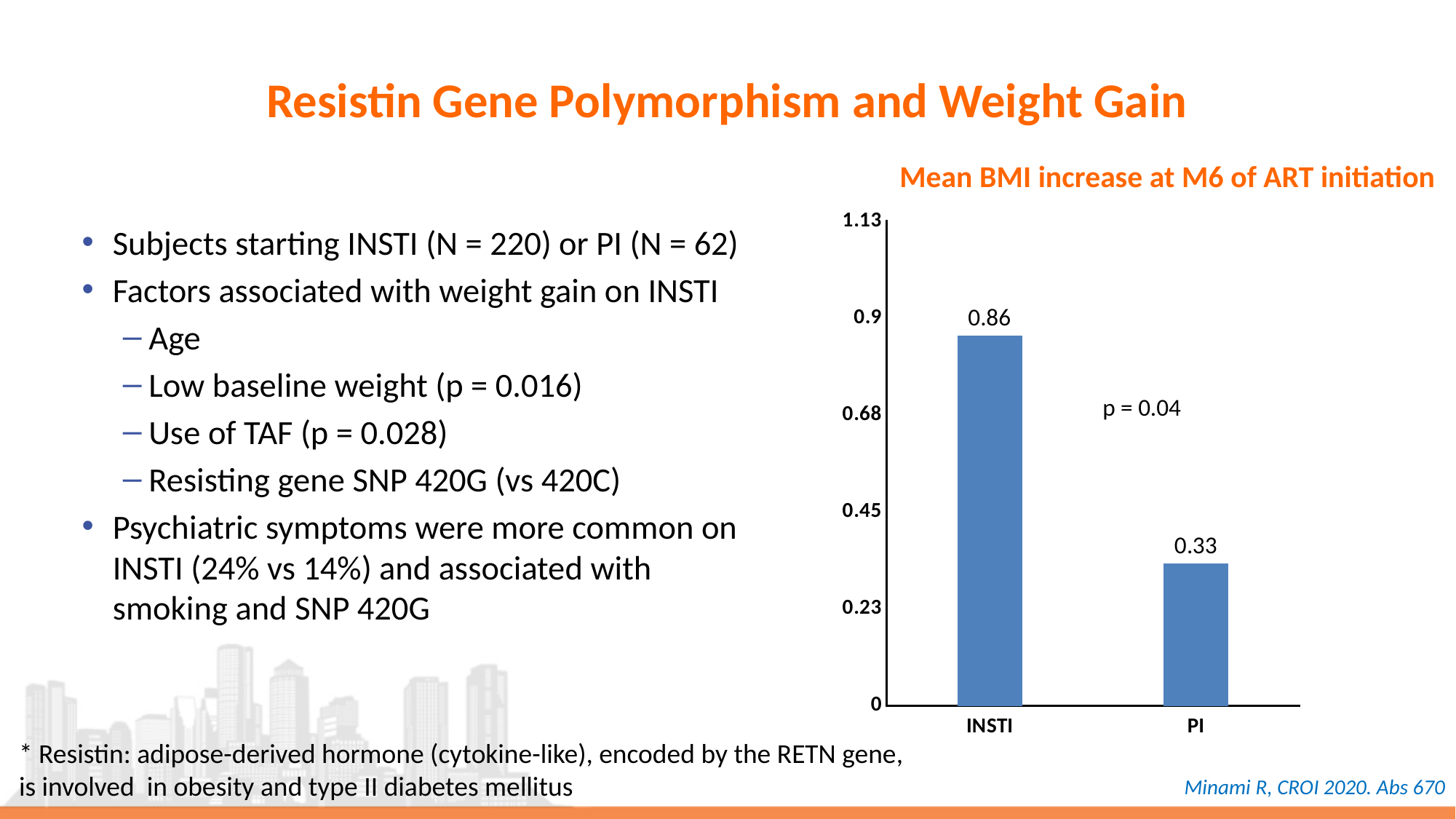
What kind of chart is shown on the slide? bar chart What p-value is shown on the chart for the comparison between INSTI and PI? p = 0.04 Is the mean BMI increase larger for INSTI or for PI? INSTI Which group has the higher mean BMI increase at M6? INSTI What is the title of the chart? Mean BMI increase at M6 of ART initiation Is the value for PI greater or less than 0.45? less How many categories are shown on the x axis of the chart? 2 Which group has the lower mean BMI increase at M6? PI What is the mean BMI increase at M6 for PI? 0.33 Is the value for INSTI greater or less than 0.68? greater What is the difference in mean BMI increase between INSTI and PI? 0.53 What is the mean BMI increase at M6 for INSTI? 0.86